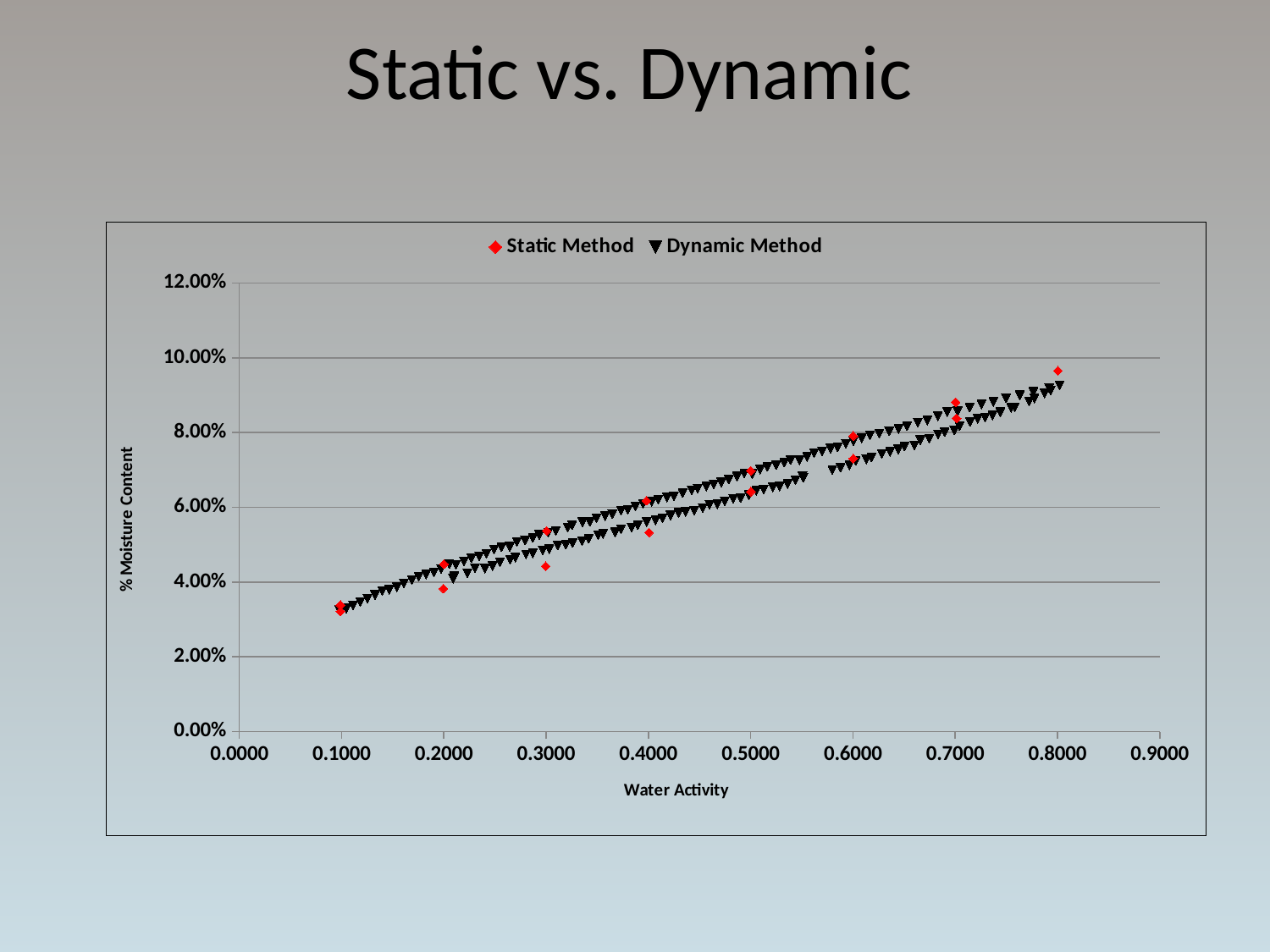
What is the maximum value shown on the y axis? 12.00% How many series does the legend list? 2 Do the Dynamic Method values rise or fall as Water Activity increases? Rise Is the highest Dynamic Method value (near Water Activity 0.8000) greater or less than 8.00%? greater What kind of chart is shown on the slide? Scatter chart At which Water Activity value does the Static Method have its lowest % Moisture Content? 0.1000 Are the Static Method values at Water Activity 0.6000 greater or less than 6.00%? greater Is the Static Method value at Water Activity 0.1000 greater or less than 4.00%? less What are the two series named in the legend? Static Method and Dynamic Method At which Water Activity value does the Static Method reach its highest % Moisture Content? 0.8000 What is the label of the x axis? Water Activity